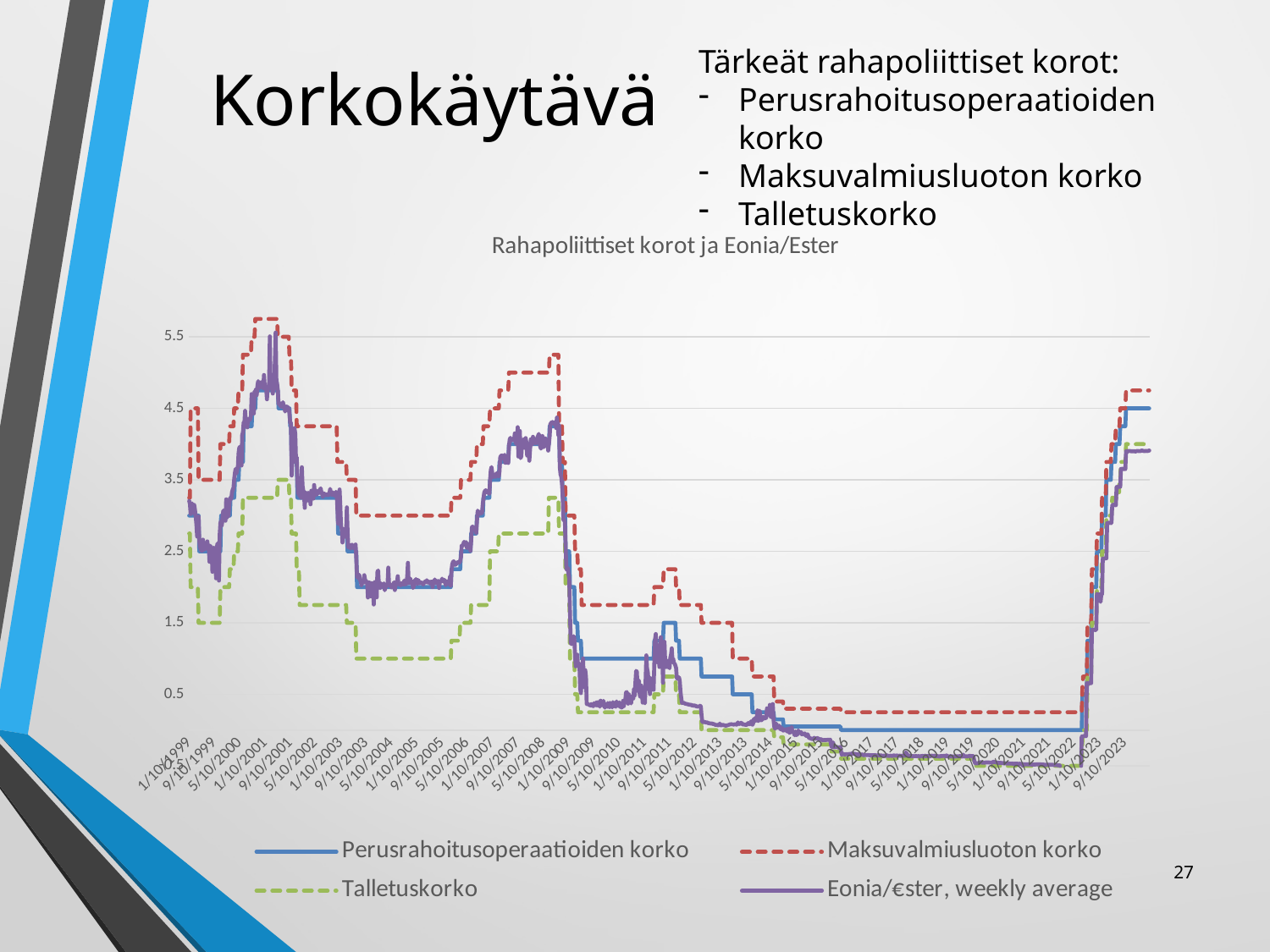
Is the value of Perusrahoitusoperaatioiden korko around 1/10/2018 greater or less than 0.5? less Which series is the lowest across the chart? Talletuskorko Is the peak value of Maksuvalmiusluoton korko in 2001 greater or less than 5.5? greater What kind of chart is shown on the slide? line chart Is the value of Talletuskorko at 9/10/2023 greater or less than 3.5? greater What is the title of the chart? Rahapoliittiset korot ja Eonia/Ester How many series does the chart legend list? 4 At 9/10/2023, which is higher: Maksuvalmiusluoton korko or Talletuskorko? Maksuvalmiusluoton korko Which series is drawn as a solid purple line? Eonia/€ster, weekly average Do the rates rise or fall between 1/10/2022 and 9/10/2023? rise